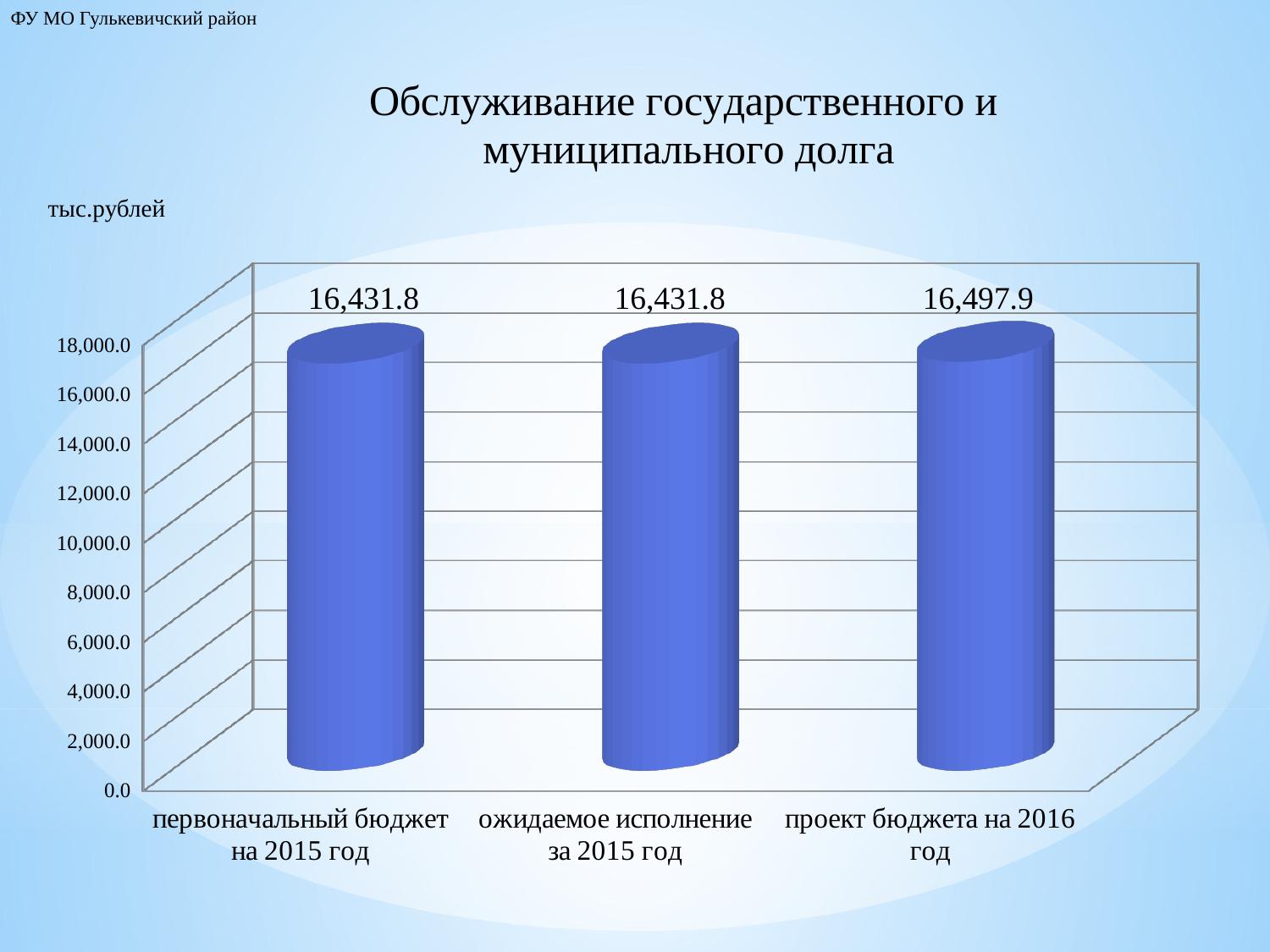
Which is larger according to the data labels: the value for «проект бюджета на 2016 год» or the value for «ожидаемое исполнение за 2015 год»? проект бюджета на 2016 год How many categories are shown on the chart? 3 What is the value for «проект бюджета на 2016 год»? 16,497.9 What is the value for «первоначальный бюджет на 2015 год»? 16,431.8 Which category has the highest value according to the data labels? проект бюджета на 2016 год What is the title of the chart? Обслуживание государственного и муниципального долга What kind of chart is shown on the slide? bar chart Is the value for «первоначальный бюджет на 2015 год» greater or less than 16,000.0? greater Is the value for «проект бюджета на 2016 год» greater or less than 18,000.0? less In what units are the values on the chart given? тыс.рублей What is the difference between the value for «проект бюджета на 2016 год» and the value for «первоначальный бюджет на 2015 год»? 66.1 What is the value for «ожидаемое исполнение за 2015 год»? 16,431.8